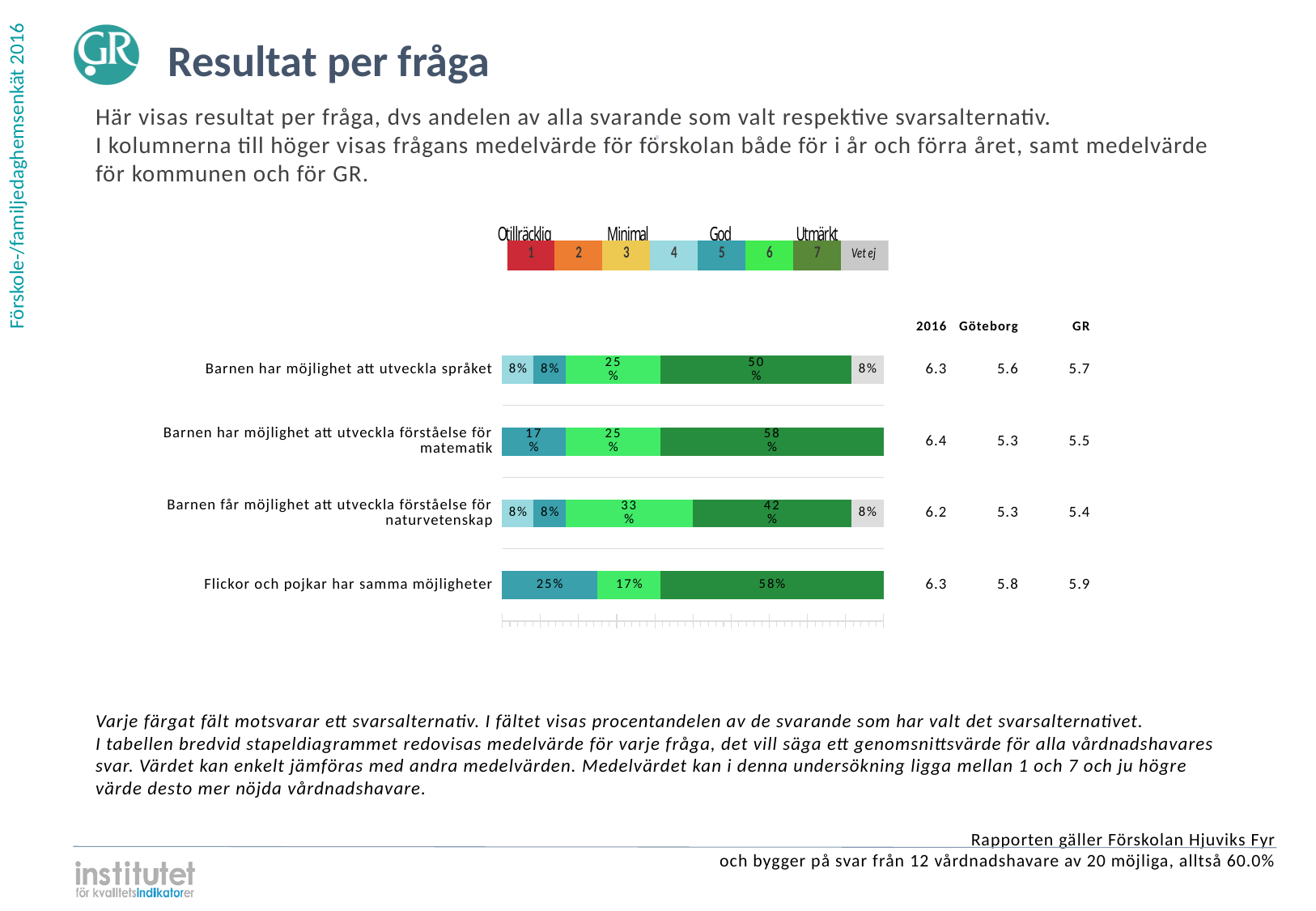
What is the difference between the option 7 share for 'Barnen har möjlighet att utveckla förståelse för matematik' (58%) and for 'Barnen har möjlighet att utveckla språket' (50%)? 8% What kind of chart is shown on the slide? Stacked bar chart What percentage of respondents chose option 6 for 'Barnen får möjlighet att utveckla förståelse för naturvetenskap'? 33% What is the 2016 mean value shown for 'Barnen har möjlighet att utveckla förståelse för matematik'? 6.4 What is the total of the printed segment values for 'Barnen har möjlighet att utveckla förståelse för matematik'? 100% How many questions (categories) are plotted in the bar chart? 4 What percentage of respondents chose option 5 for 'Flickor och pojkar har samma möjligheter'? 25% What percentage of respondents chose option 7 for 'Barnen har möjlighet att utveckla språket'? 50% How many response options does the legend above the chart list? 8 Which question has the smallest share of respondents choosing option 7? Barnen får möjlighet att utveckla förståelse för naturvetenskap Which question has the largest share of respondents choosing option 7? Barnen har möjlighet att utveckla förståelse för matematik and Flickor och pojkar har samma möjligheter (58% each) Which is larger: the option 6 share for 'Barnen får möjlighet att utveckla förståelse för naturvetenskap' or for 'Flickor och pojkar har samma möjligheter'? Barnen får möjlighet att utveckla förståelse för naturvetenskap